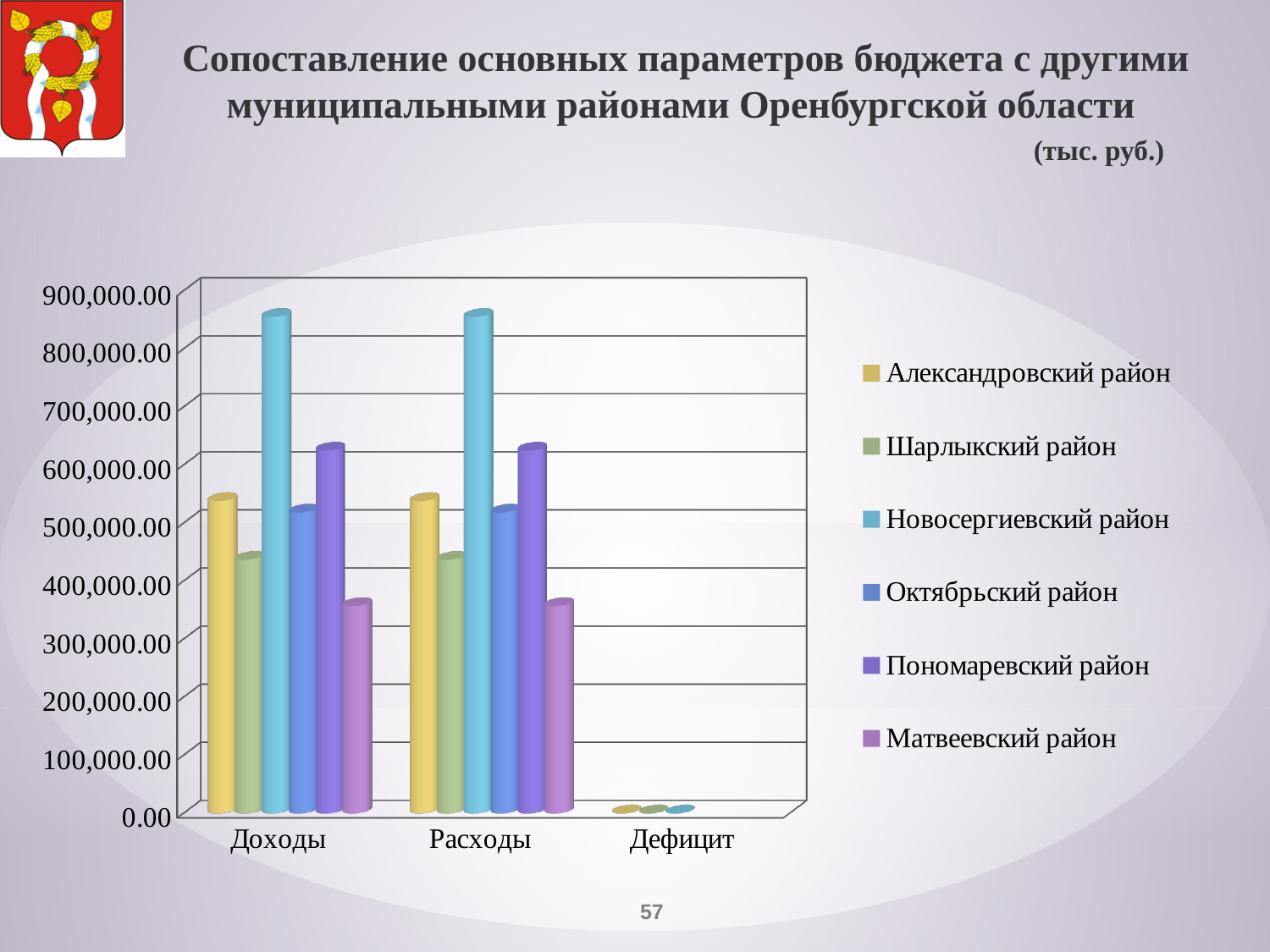
Which district has the highest value for Расходы? Новосергиевский район How many categories are shown on the x axis of the chart? 3 Which district has the lowest value for Доходы? Матвеевский район How many series does the legend list? 6 Is the value for Новосергиевский район in Доходы greater or less than 800,000.00? greater For Доходы, which is larger: the value for Александровский район or the value for Шарлыкский район? Александровский район Which district has the highest value for Доходы? Новосергиевский район What kind of chart is shown on the slide? bar chart Is the value for Матвеевский район in Расходы greater or less than 400,000.00? less Is the value for Пономаревский район in Доходы greater or less than 500,000.00? greater Which district is shown in light blue in the legend? Новосергиевский район For Расходы, which is larger: the value for Пономаревский район or the value for Октябрьский район? Пономаревский район